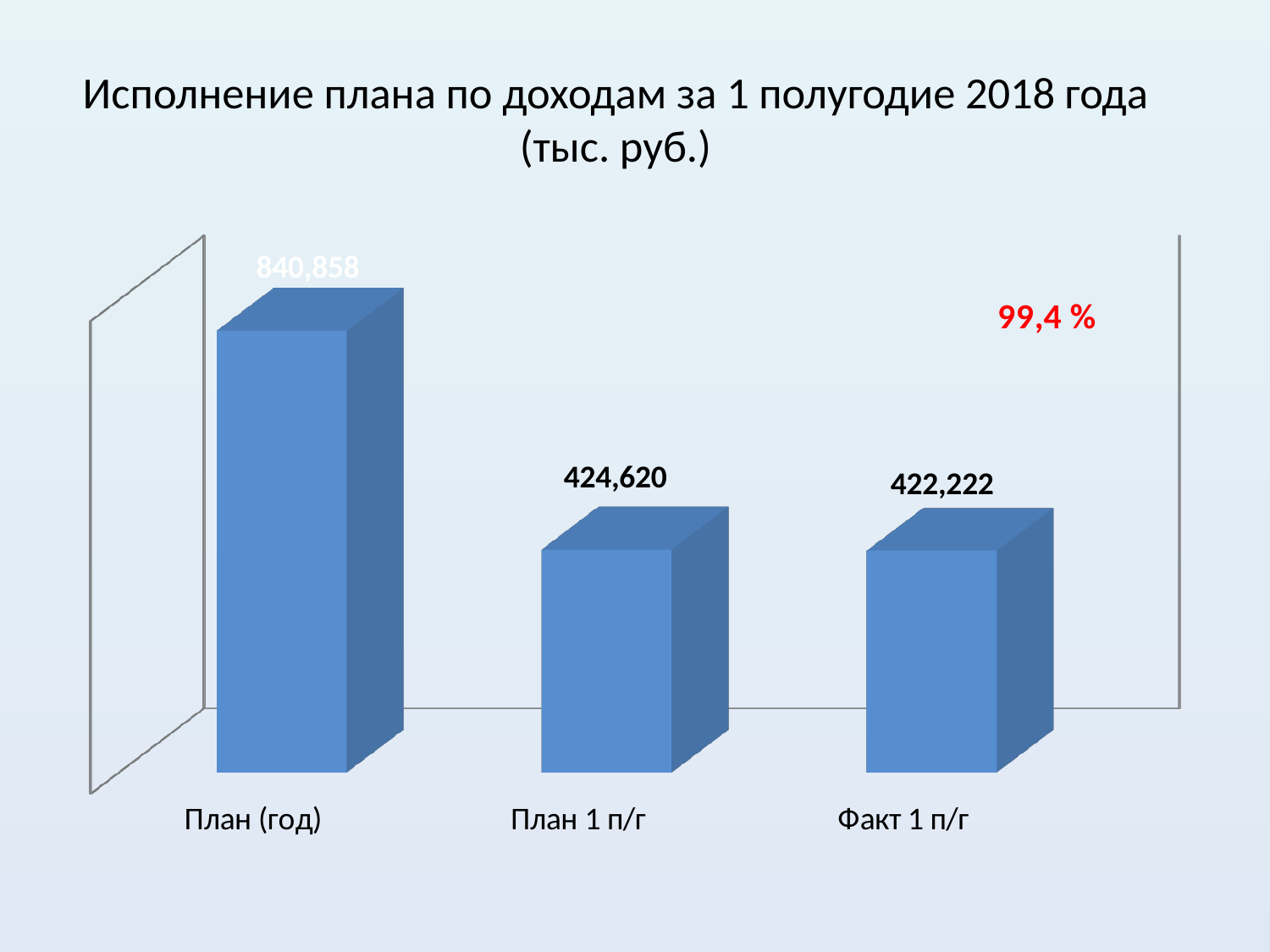
What is the difference between the values for План (год) and План 1 п/г? 416,238 What unit is given in the slide title? тыс. руб. Which is larger, the value for План 1 п/г or the value for Факт 1 п/г? План 1 п/г What is the value for Факт 1 п/г? 422,222 What is the value for План (год)? 840,858 What is the difference between the values for План 1 п/г and Факт 1 п/г? 2,398 How many categories are shown in the chart? 3 Which category has the highest value? План (год) Which category has the lowest value? Факт 1 п/г What is the value for План 1 п/г? 424,620 What percentage is shown in red text on the chart? 99,4 % What kind of chart is shown on the slide? Bar chart